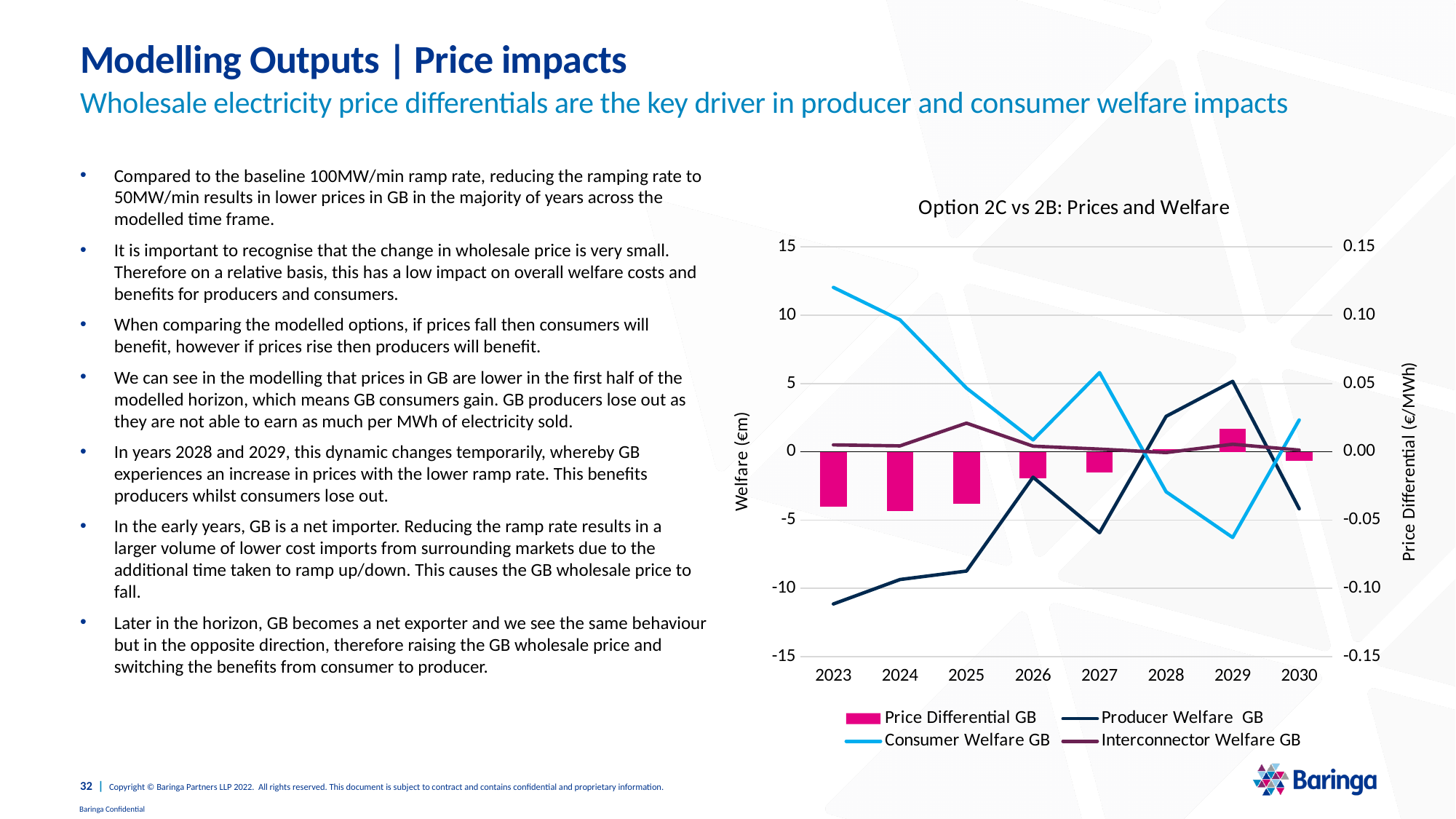
How many years are shown on the x axis of the chart? 8 Does Consumer Welfare GB rise or fall from 2023 to 2026? fall Is the value for Consumer Welfare GB in 2023 greater or less than 10? greater Is the value for Producer Welfare GB in 2023 greater or less than -10? less In which year is Consumer Welfare GB highest? 2023 In which year is Producer Welfare GB lowest? 2023 How many series does the chart legend list? 4 In 2023, which is larger: Consumer Welfare GB or Producer Welfare GB? Consumer Welfare GB Is the value for Consumer Welfare GB in 2029 greater or less than -5? less What kind of chart is shown on the slide? Combined bar and line chart What is the title of the chart on the slide? Option 2C vs 2B: Prices and Welfare Which series in the chart is plotted as bars? Price Differential GB